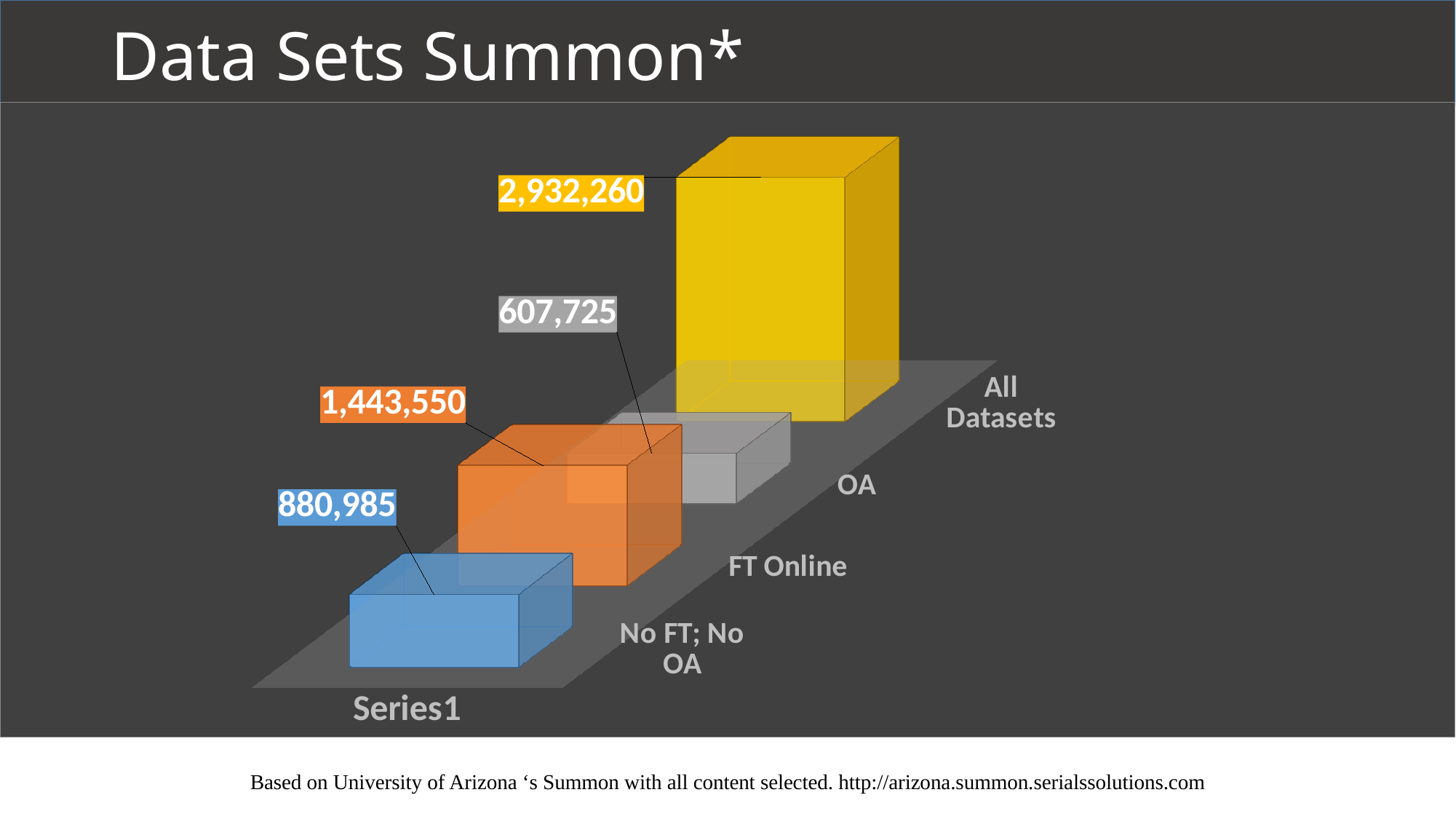
Which category has the highest value? All Datasets What is the value for FT Online? 1,443,550 Which category has the lowest value? OA What is the value for All Datasets? 2,932,260 What is the difference between the values for No FT; No OA and OA? 273,260 What kind of chart is shown on the slide? Bar chart What is the value for No FT; No OA? 880,985 Which is larger, the value for FT Online or the value for No FT; No OA? FT Online How many categories are shown in the chart? 4 What is the value for OA? 607,725 What is the title of the slide containing the chart? Data Sets Summon* What is the difference between the values for All Datasets and FT Online? 1,488,710